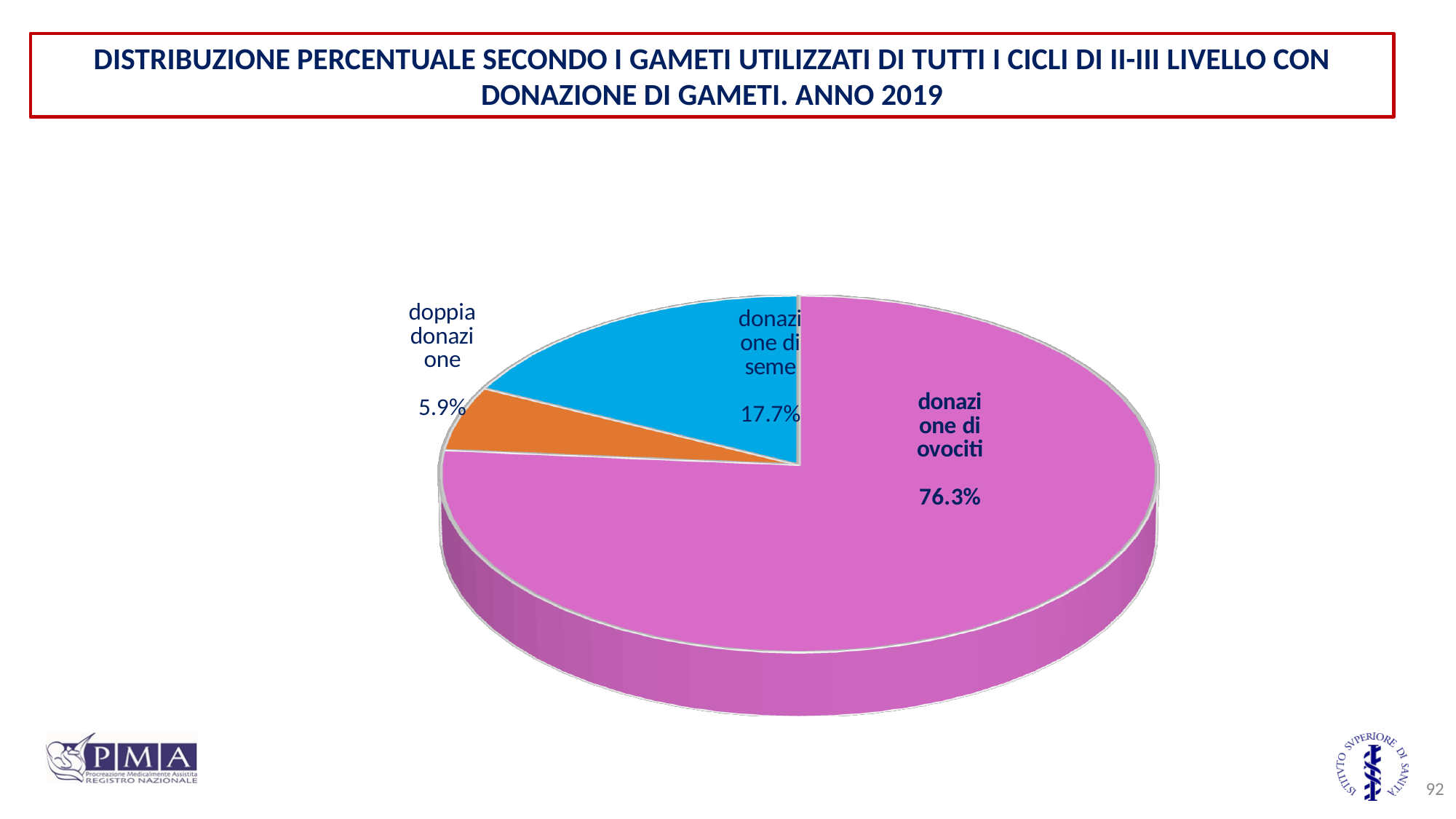
What is the difference in percentage points between 'donazione di seme' and 'doppia donazione'? 11.8 What percentage of the pie is labelled 'donazione di ovociti'? 76.3% What percentage of the pie is labelled 'doppia donazione'? 5.9% What percentage of the pie is labelled 'donazione di seme'? 17.7% Which category has the smallest share of the pie? doppia donazione How many slices does the pie chart have? 3 What colour is the 'donazione di ovociti' slice? pink What kind of chart is shown on the slide? pie chart What is the difference in percentage points between 'donazione di ovociti' and 'donazione di seme'? 58.6 What year does the chart title refer to? 2019 Which category has the largest share of the pie? donazione di ovociti Which is larger: the share for 'donazione di seme' or the share for 'doppia donazione'? donazione di seme